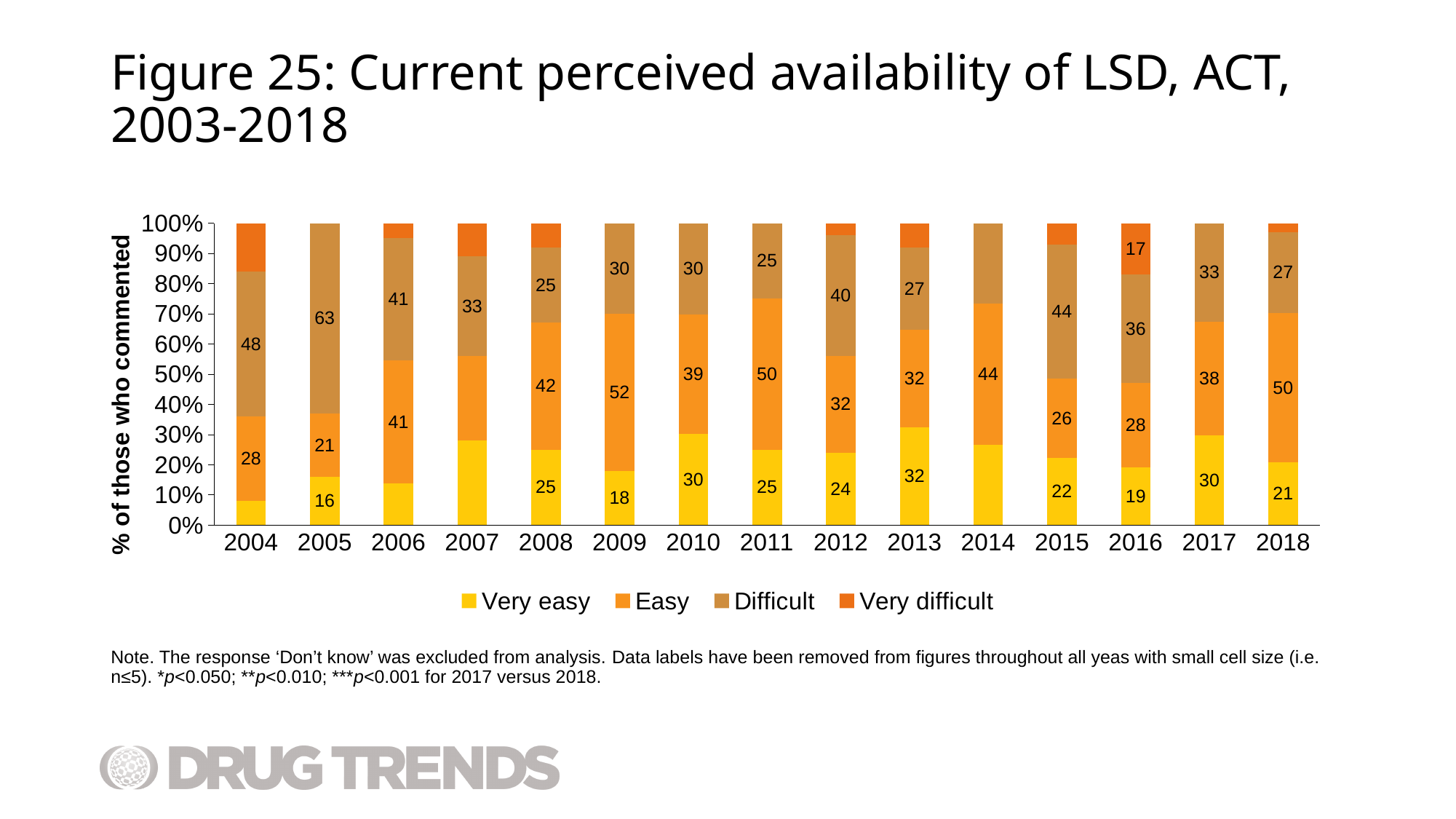
What is the difference between the Easy value in 2018 and the Easy value in 2015? 24 Among the labelled Very easy values, which year has the lowest? 2005 What is the value for Very easy in 2013? 32 How many years are shown on the x axis? 15 Among the labelled Difficult values, which year has the highest? 2005 Which is larger, the Difficult value in 2015 or the Difficult value in 2017? 2015 What is the value for Difficult in 2005? 63 What is the value for Easy in 2009? 52 What is the value for Very difficult in 2016? 17 Is the top of the Very easy segment in 2007 greater or less than 20%? greater How many series does the legend list? 4 What kind of chart is shown on the slide? Stacked bar chart